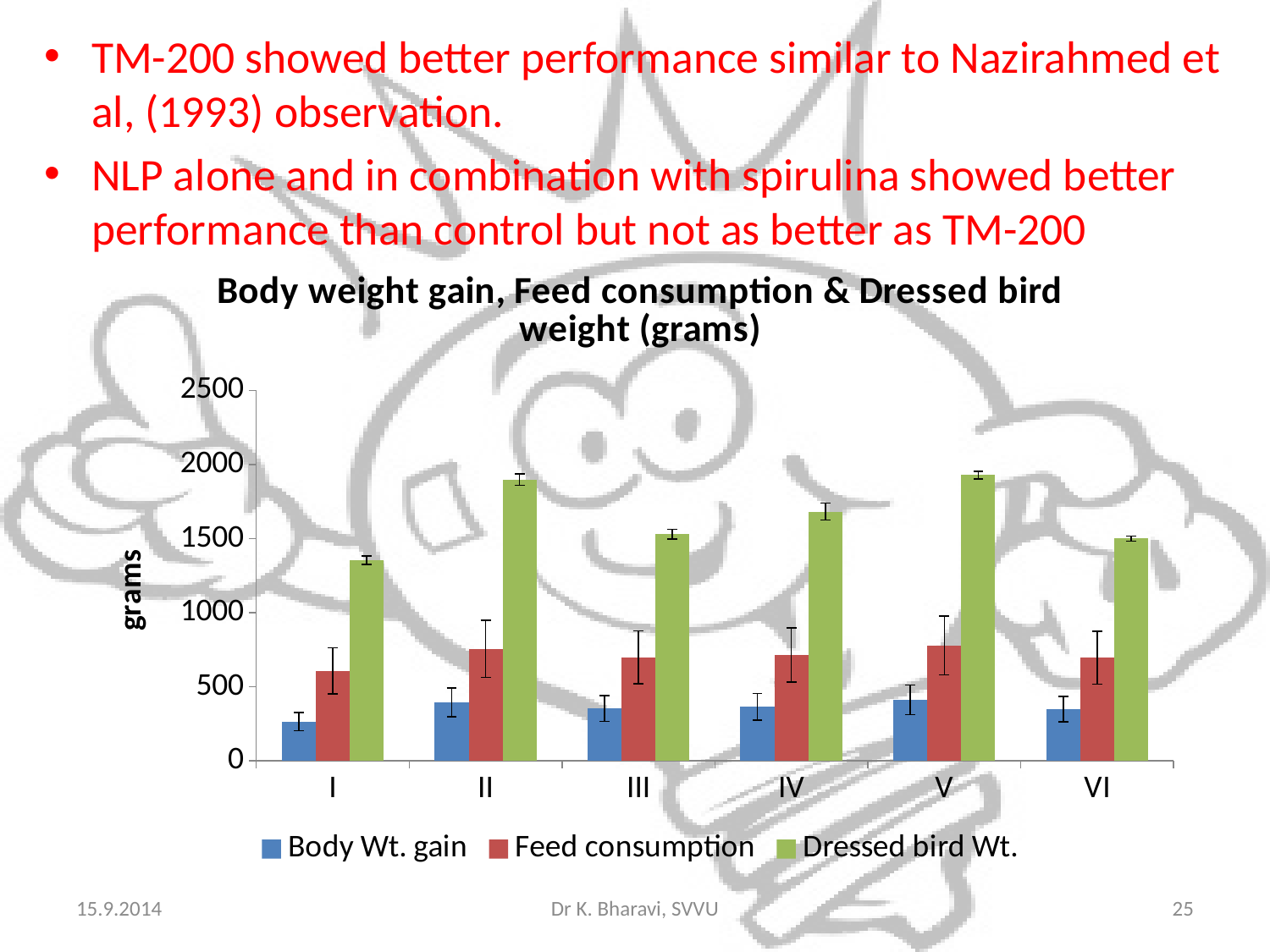
What is the label on the vertical axis? grams Is the Body Wt. gain for group I greater or less than 500? less Which is larger, the Dressed bird Wt. for group IV or for group VI? group IV Which group has the lowest Dressed bird Wt.? I Is the Dressed bird Wt. for group I greater or less than 1500? less Which group has the lowest Body Wt. gain? I Is the Dressed bird Wt. for group II greater or less than 1500? greater How many groups (categories) are shown on the x axis? 6 Which is larger, the Dressed bird Wt. for group II or for group III? group II How many series does the legend list? 3 Which group has the lowest Feed consumption? I What kind of chart is shown on the slide? bar chart